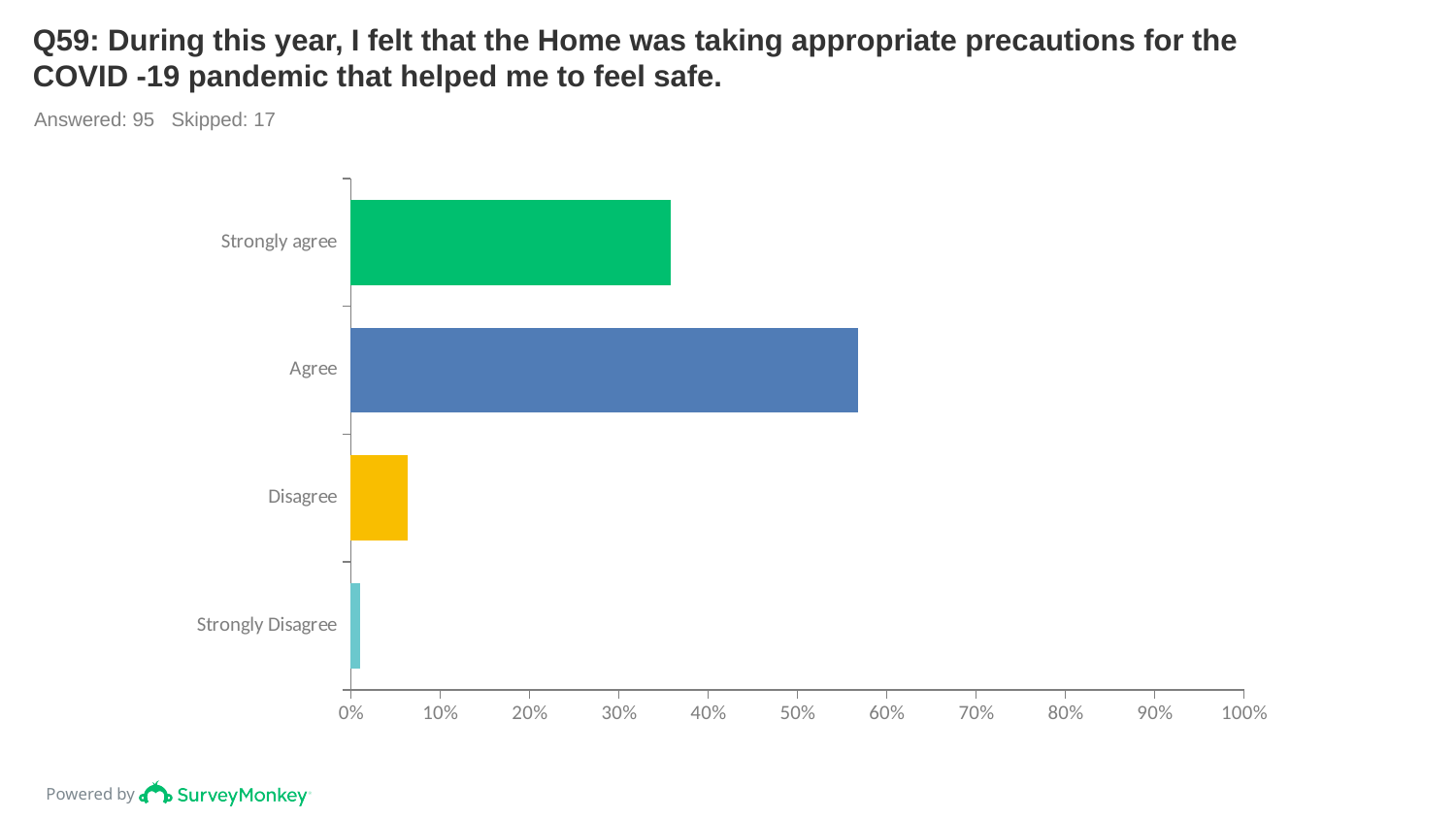
Is the value for Agree greater or less than 50%? greater What is the maximum value shown on the horizontal axis? 100% Which response category has the lowest value? Strongly Disagree Is the value for Strongly agree greater or less than 40%? less Is the value for Disagree greater or less than 10%? less How many respondents answered this question according to the slide? 95 What kind of chart is shown on the slide? bar chart Which is larger, the value for Disagree or the value for Strongly Disagree? Disagree Which is larger, the value for Strongly agree or the value for Agree? Agree How many response categories are shown in the chart? 4 Which response category has the highest value? Agree